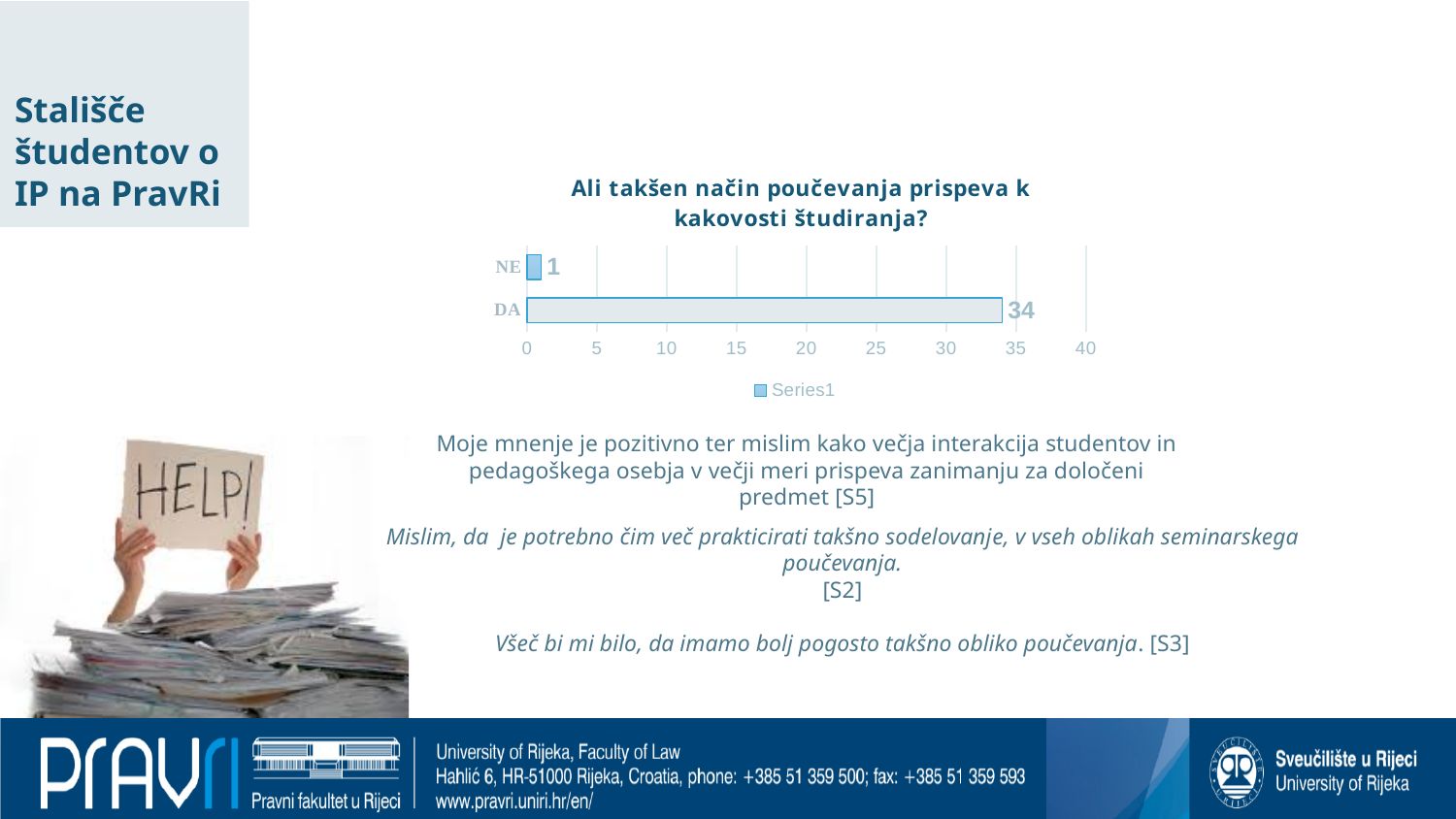
What is the name of the series listed in the legend? Series1 How many categories are shown in the chart? 2 What is the difference between the values for DA and NE? 33 Is the value for DA greater or less than 30? greater How many series does the legend list? 1 Which category has the highest value in the chart? DA What is the title of the chart? Ali takšen način poučevanja prispeva k kakovosti študiranja? What is the value for NE in the chart? 1 Which is larger, the value for DA or the value for NE? DA Which category has the lowest value in the chart? NE What is the value for DA in the chart? 34 What kind of chart is shown on the slide? bar chart